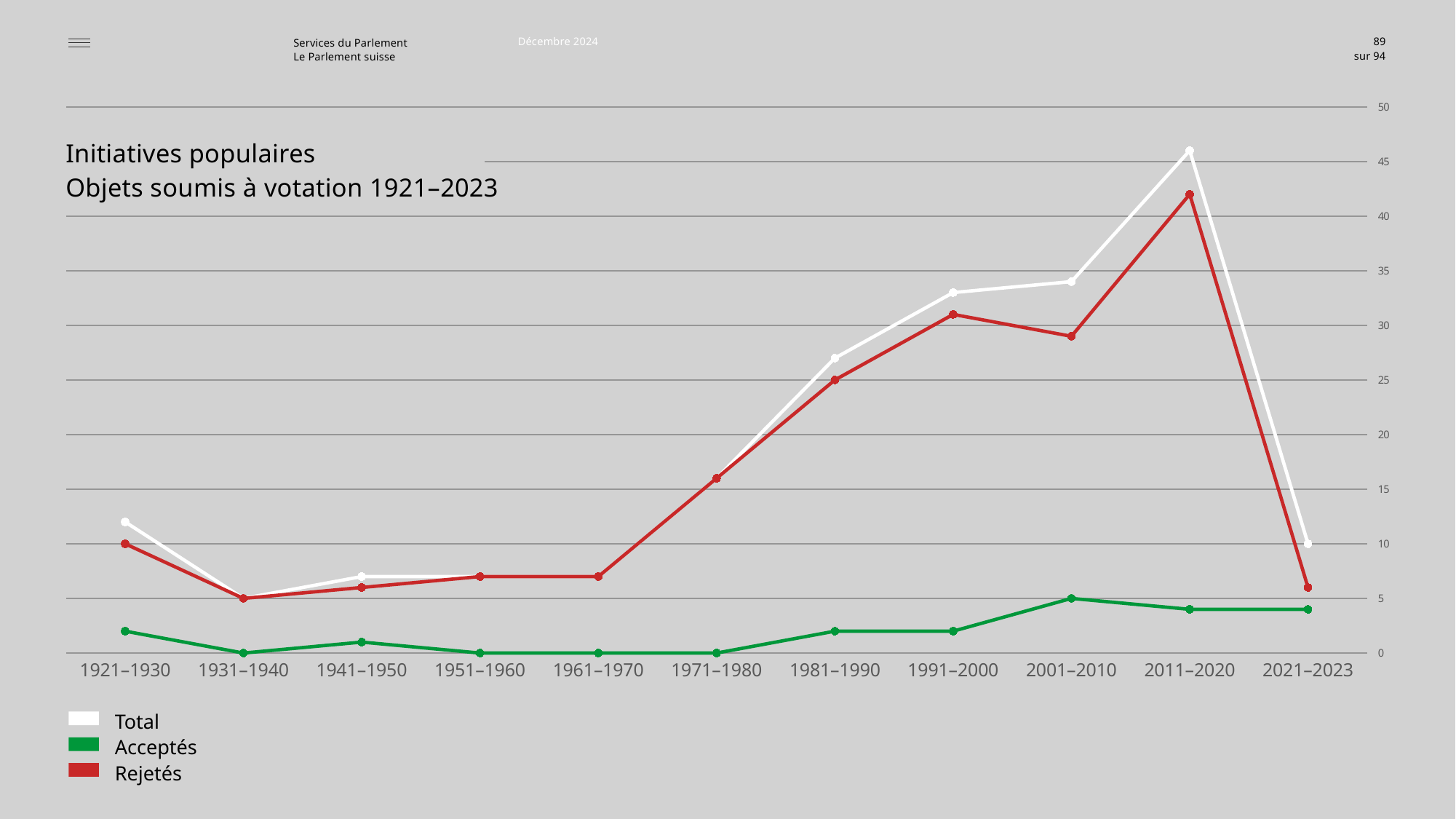
In which period does the Rejetés series reach its highest value? 2011–2020 What is the value of Rejetés for 1931–1940? 5 Does the Total series rise or fall from 1961–1970 to 2011–2020? rise Is the value of Rejetés for 1991–2000 greater or less than 30? greater How many series does the legend list? 3 How many periods are shown along the x axis? 11 What is the value of Rejetés for 1981–1990? 25 Is the value of Total for 2011–2020 greater or less than 45? greater What is the value of Total for 2021–2023? 10 In which period does the Total series reach its highest value? 2011–2020 What is the value of Acceptés for 2001–2010? 5 What kind of chart is shown on the slide? line chart